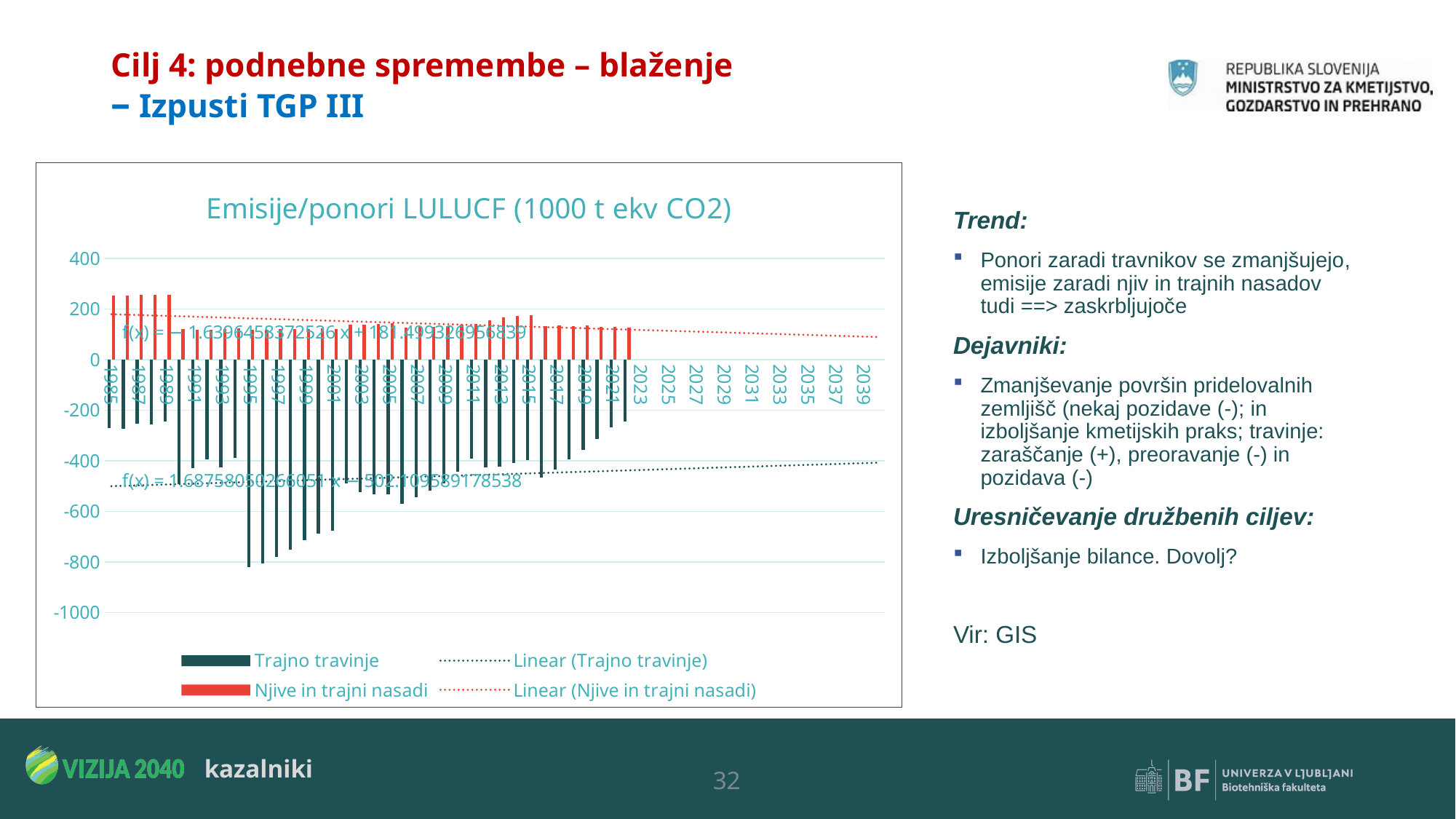
Which series has negative values throughout the chart? Trajno travinje In which year does the Trajno travinje series reach its lowest (most negative) value? 1995 Which series is drawn in red bars? Njive in trajni nasadi Is the value for Njive in trajni nasadi in 1985 greater or less than 200? greater What is the title of the chart? Emisije/ponori LULUCF (1000 t ekv CO2) Is the value for Njive in trajni nasadi in 2021 greater or less than 200? less Is the value for Trajno travinje in 2021 greater or less than -400? greater How many year labels are shown on the x axis? 28 How many entries does the chart legend list? 4 Do the Trajno travinje values move closer to zero or further from zero from 1995 to 2021? closer to zero What kind of chart is shown on the slide? bar chart